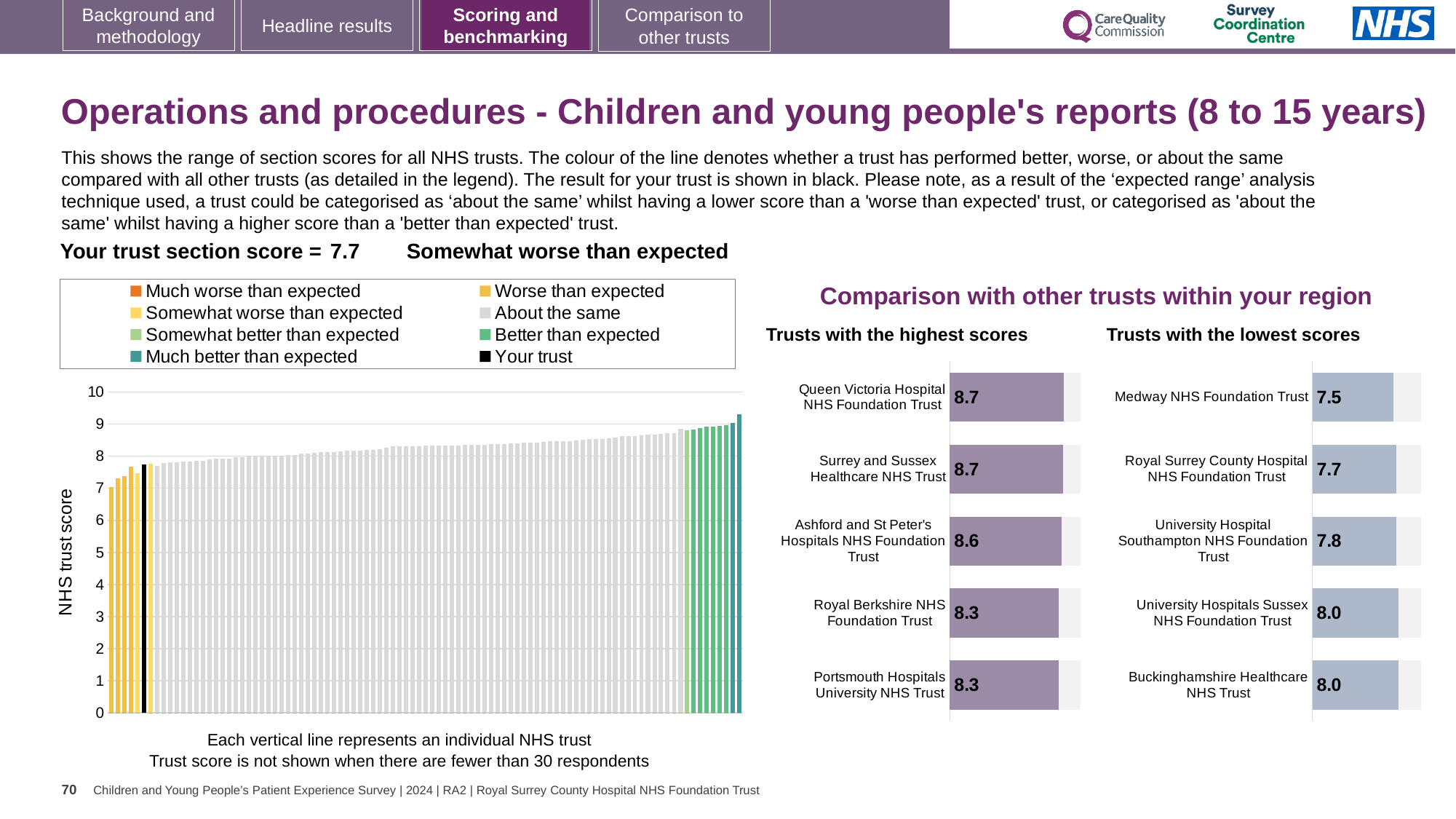
In the 'Trusts with the highest scores' chart, what is the difference between the scores of Ashford and St Peter's Hospitals NHS Foundation Trust and Royal Berkshire NHS Foundation Trust? 0.3 What kind of chart is the large chart on the left showing NHS trust scores? Bar chart In the 'Trusts with the lowest scores' chart, which has the larger score: Medway NHS Foundation Trust or Royal Surrey County Hospital NHS Foundation Trust? Royal Surrey County Hospital NHS Foundation Trust In the 'Trusts with the highest scores' chart, what is the score for Queen Victoria Hospital NHS Foundation Trust? 8.7 In the 'Trusts with the highest scores' chart, what is the score for Ashford and St Peter's Hospitals NHS Foundation Trust? 8.6 How many trusts are shown in the 'Trusts with the lowest scores' chart? 5 In the large chart on the left, do the trust scores rise or fall from left to right? Rise In the 'Trusts with the lowest scores' chart, which trust has the lowest score? Medway NHS Foundation Trust In the large chart on the left, is the value for the black 'Your trust' bar greater or less than 8? less In the 'Trusts with the lowest scores' chart, what is the score for University Hospital Southampton NHS Foundation Trust? 7.8 How many entries does the legend above the large chart on the left list? 8 In the 'Trusts with the lowest scores' chart, what is the score for Medway NHS Foundation Trust? 7.5